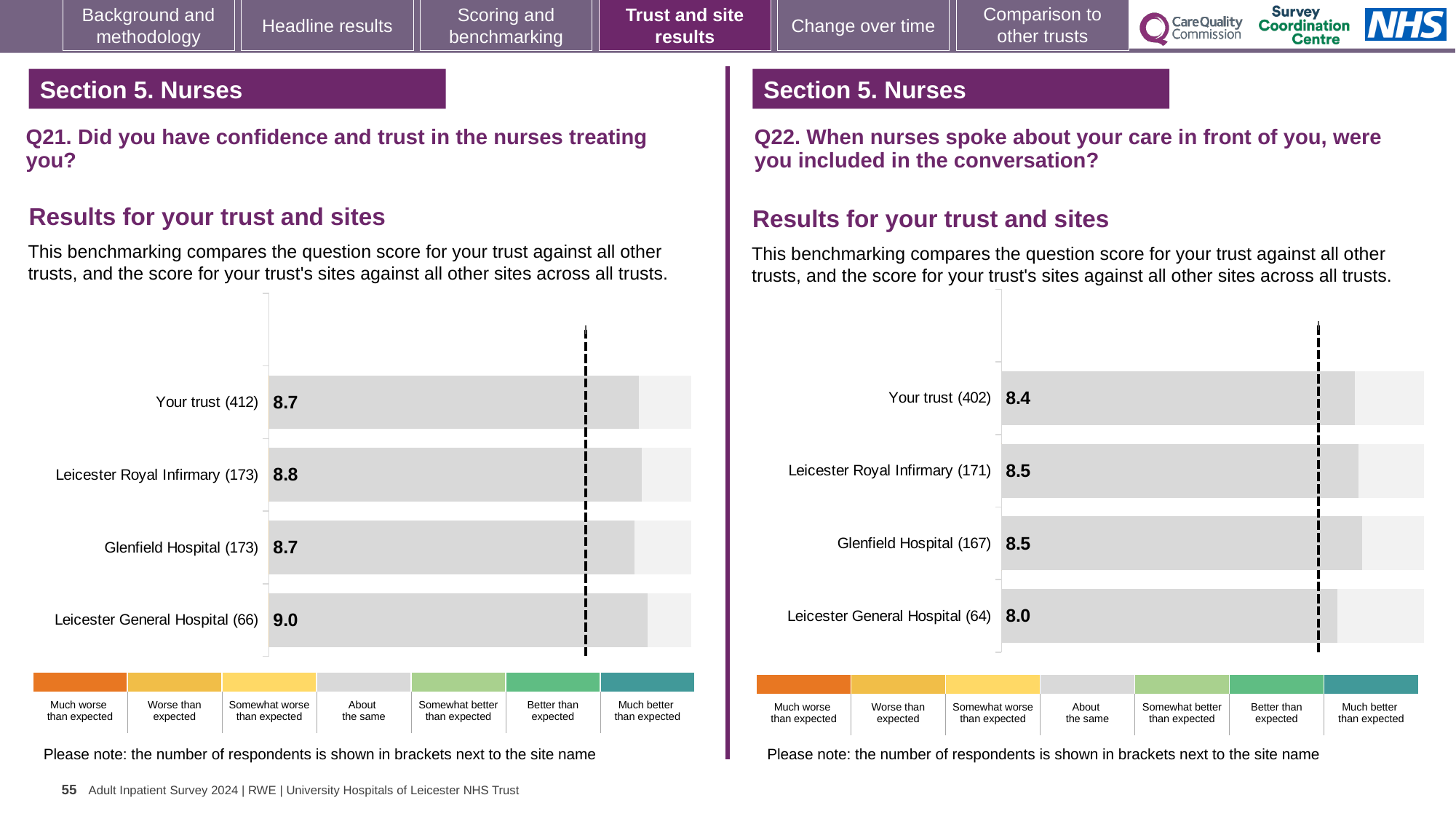
In the Q22 chart on the right, which has the larger score, Your trust or Leicester General Hospital? Your trust In the Q22 chart on the right, how many respondents are shown in brackets for Leicester Royal Infirmary? 171 In the Q22 chart on the right, what is the score for Leicester General Hospital? 8.0 In the Q21 chart on the left, what is the score for Your trust? 8.7 In the Q22 chart on the right, what is the difference between the scores for Leicester Royal Infirmary and Leicester General Hospital? 0.5 In the Q21 chart on the left, what is the difference between the scores for Leicester General Hospital and Your trust? 0.3 In the Q21 chart on the left, which site or trust has the highest score? Leicester General Hospital In the Q22 chart on the right, what is the score for Glenfield Hospital? 8.5 In the Q21 chart on the left, what is the score for Leicester General Hospital? 9.0 How many bars are plotted in the Q21 chart on the left? 4 What type of chart is used for the Q22 results on the right? Bar chart In the Q22 chart on the right, which site or trust has the lowest score? Leicester General Hospital